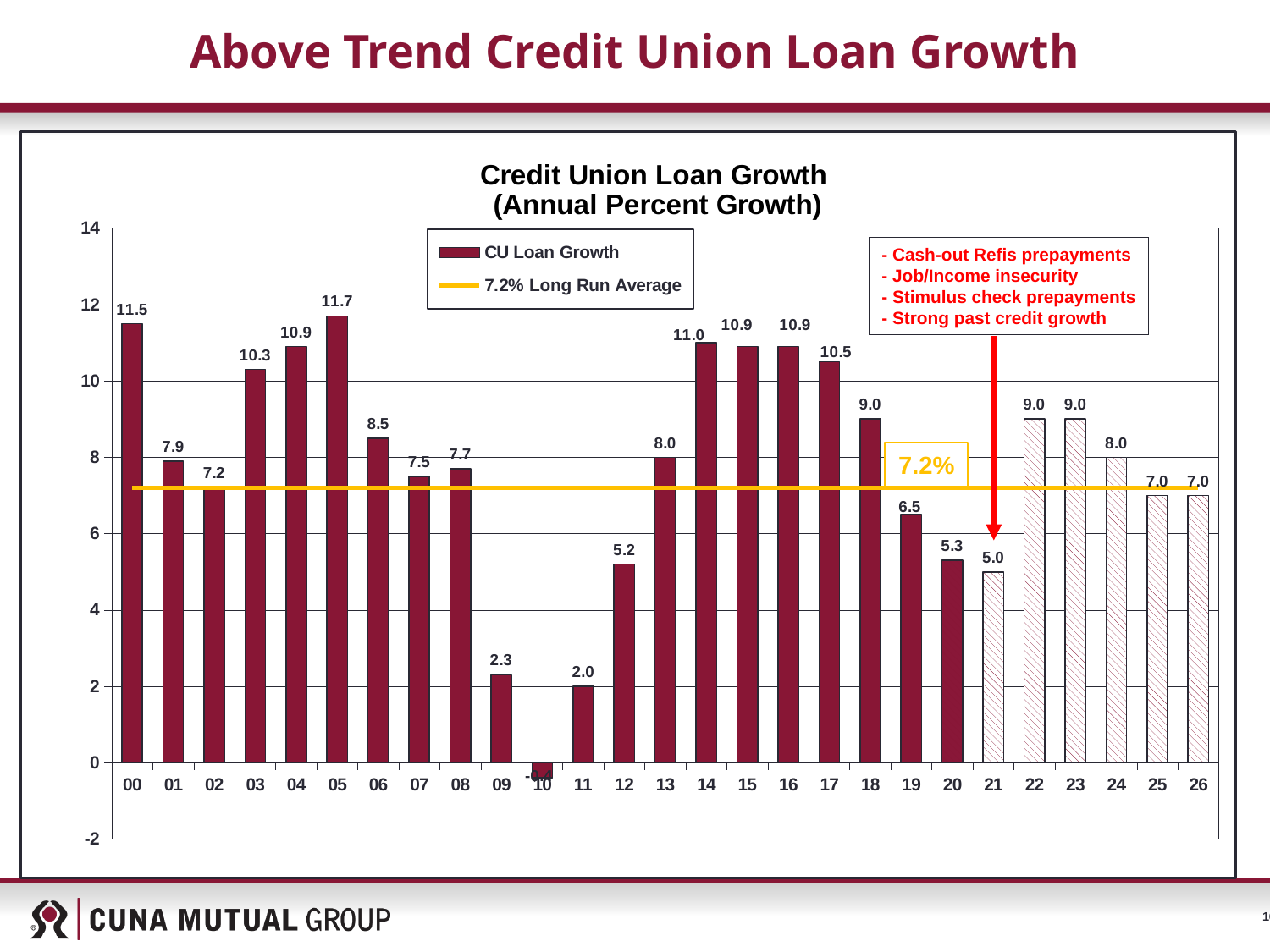
Is the CU Loan Growth value for 09 greater or less than 4? less What value does the long run average line in the chart represent? 7.2% What is the CU Loan Growth value for 05? 11.7 Which is larger, the CU Loan Growth value for 12 or for 13? 13 Which year has the lowest CU Loan Growth value? 10 How many entries does the chart legend list? 2 How many years are shown on the x axis of the chart? 27 What kind of chart is shown on the slide? bar chart Which year has the highest CU Loan Growth value? 05 What is the difference between the CU Loan Growth values for 00 and 01? 3.6 What is the CU Loan Growth value for 21? 5.0 What is the CU Loan Growth value for 19? 6.5